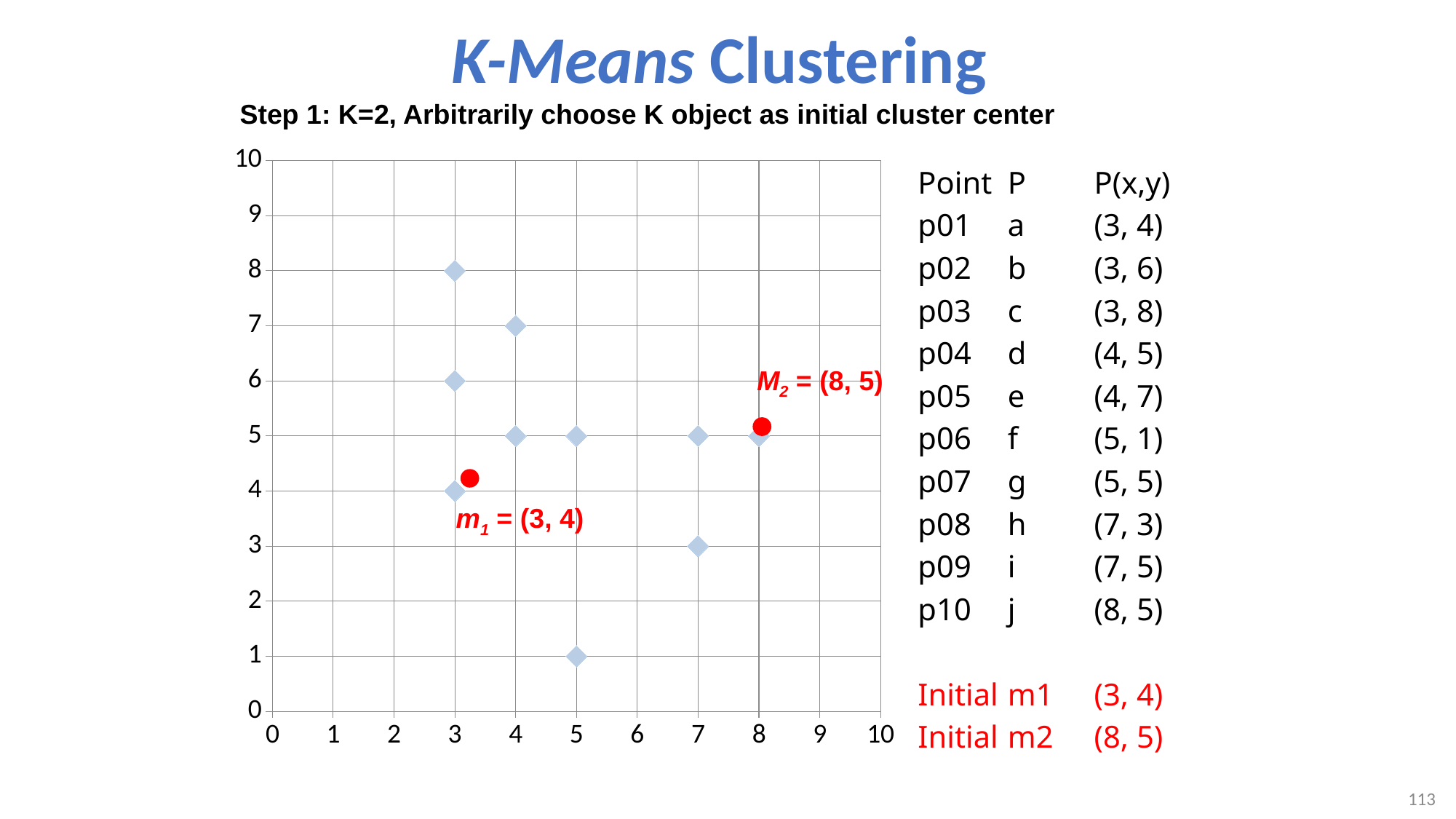
What kind of chart is shown on the slide? scatter plot Which point has the largest x-value in the chart? j (8, 5) What are the coordinates of the initial cluster center m1 marked on the chart? (3, 4) Which point has a larger y-value, point c or point e? c How many plotted points have a y-value of 5? 4 What is the y-coordinate of point h (p08)? 3 What is the difference between the x-coordinates of M2 and m1? 5 Which point has the highest y-value in the chart? c (3, 8) Is the y-value of point f greater or less than 2? less Which point has the lowest y-value in the chart? f (5, 1) How many data points are plotted in the scatter chart? 10 What are the coordinates of the initial cluster center M2 marked on the chart? (8, 5)